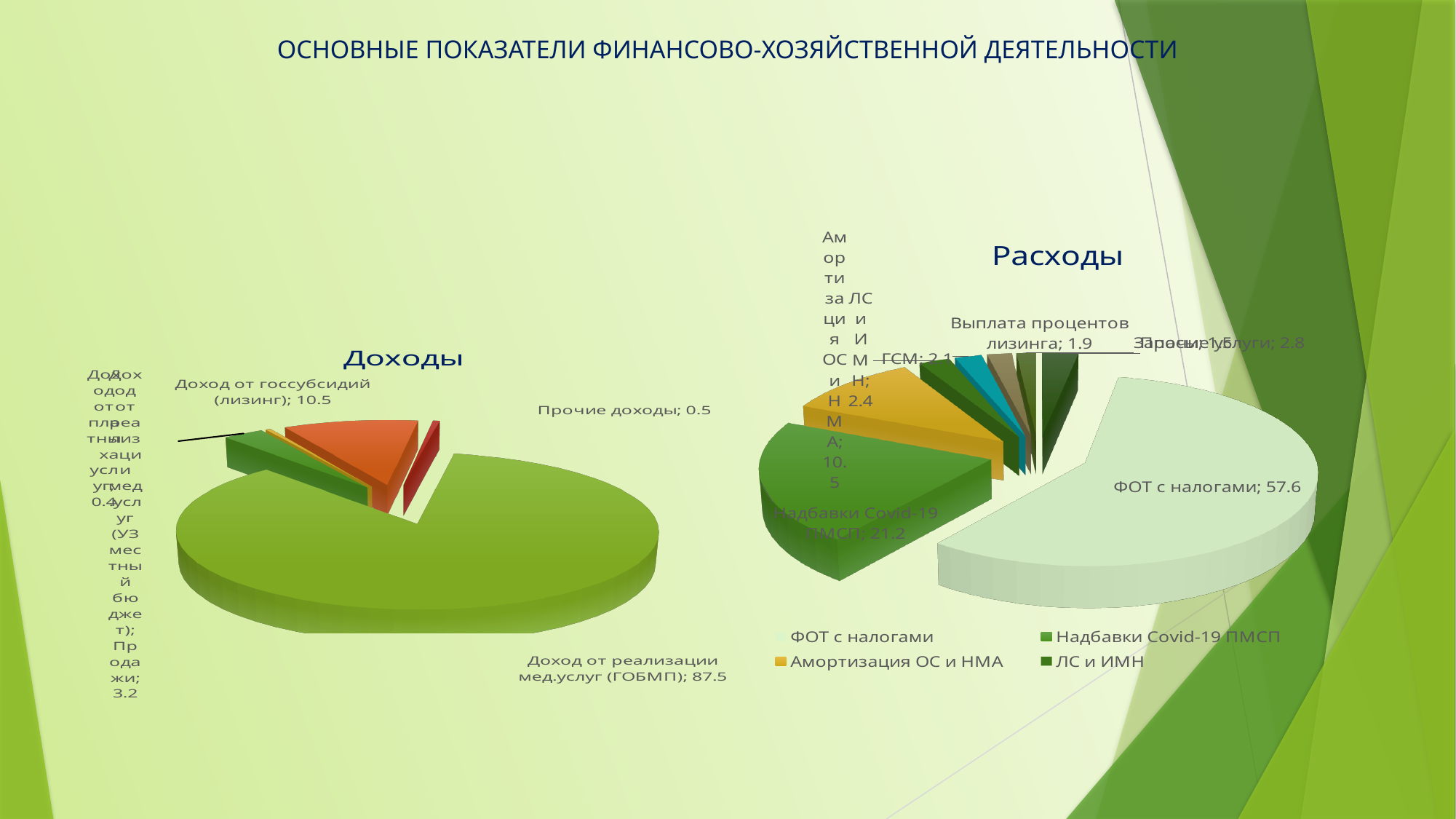
In the Расходы chart, what is the value for ФОТ с налогами? 57.6 In the Расходы chart, what is the value for Надбавки Covid-19 ПМСП? 21.2 In the Доходы chart, what is the value for Прочие доходы? 0.5 What kind of chart is the Доходы chart? Pie chart In the Расходы chart, what is the value for Амортизация ОС и НМА? 10.5 In the Доходы chart, what is the value for Доход от реализации мед.услуг (ГОБМП)? 87.5 In the Доходы chart, which category has the largest slice? Доход от реализации мед.услуг (ГОБМП) In the Расходы chart, which is larger: Амортизация ОС и НМА or Надбавки Covid-19 ПМСП? Надбавки Covid-19 ПМСП In the Расходы chart, which category has the largest slice? ФОТ с налогами In the Расходы chart, what is the value for Выплата процентов лизинга? 1.9 In the Доходы chart, what is the value for Доход от госсубсидий (лизинг)? 10.5 In the Расходы chart, what is the difference between ФОТ с налогами and Надбавки Covid-19 ПМСП? 36.4